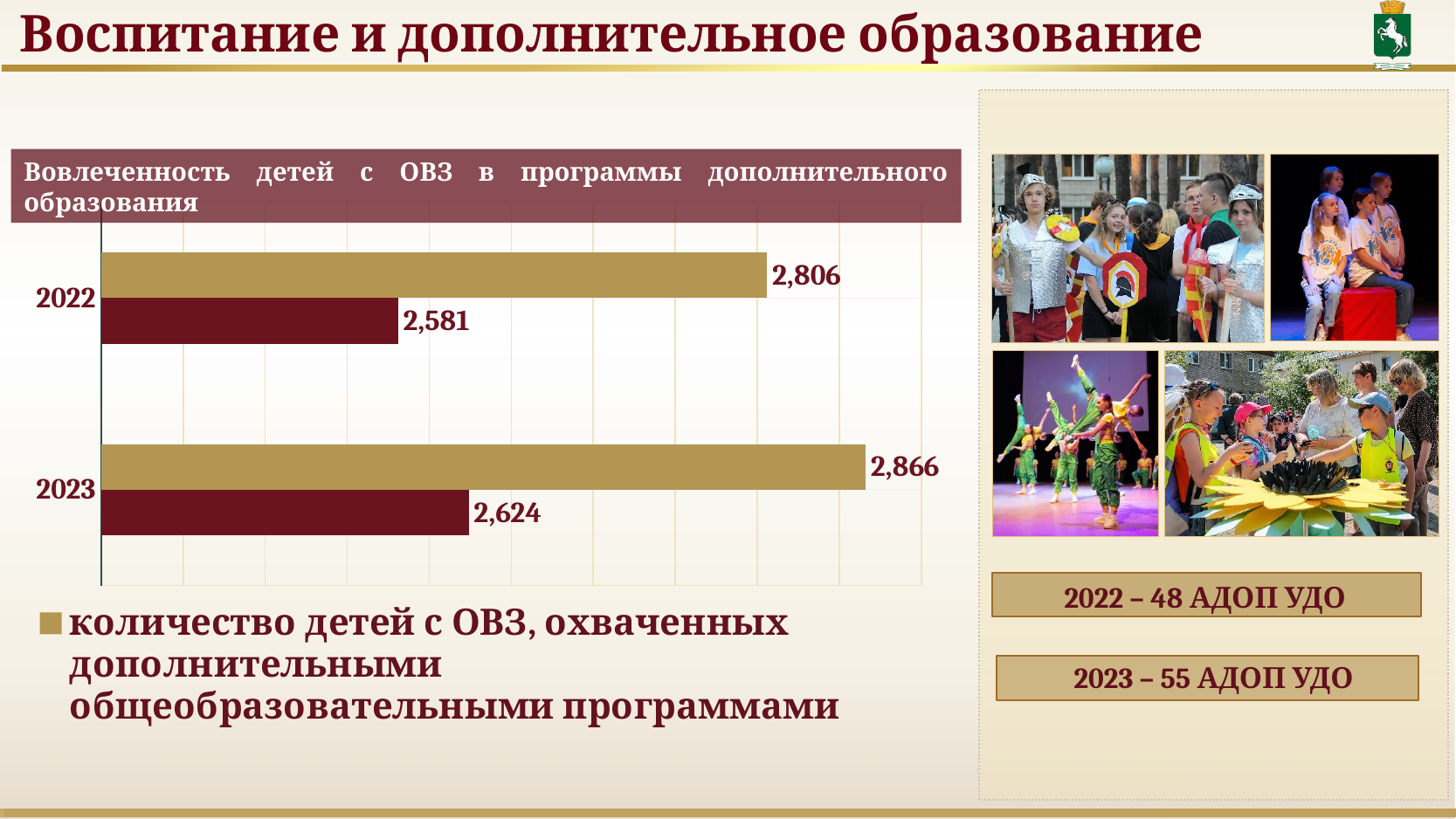
Which year has the higher value for the dark red series, 2022 or 2023? 2023 How many years (categories) are shown on the chart? 2 What is the value of the dark red bar for 2023? 2,624 What is the value of the gold bar (количество детей с ОВЗ, охваченных дополнительными общеобразовательными программами) for 2023? 2,866 By how much did the gold series (количество детей с ОВЗ, охваченных дополнительными общеобразовательными программами) increase from 2022 to 2023? 60 What is the title of the chart? Вовлеченность детей с ОВЗ в программы дополнительного образования What is the difference between the gold bar and the dark red bar for 2023? 242 What is the value of the gold bar (количество детей с ОВЗ, охваченных дополнительными общеобразовательными программами) for 2022? 2,806 Does the gold series (количество детей с ОВЗ, охваченных дополнительными общеобразовательными программами) rise or fall from 2022 to 2023? rise What is the value of the dark red bar for 2022? 2,581 What is the difference between the gold bar and the dark red bar for 2022? 225 What type of chart is shown on the slide? bar chart